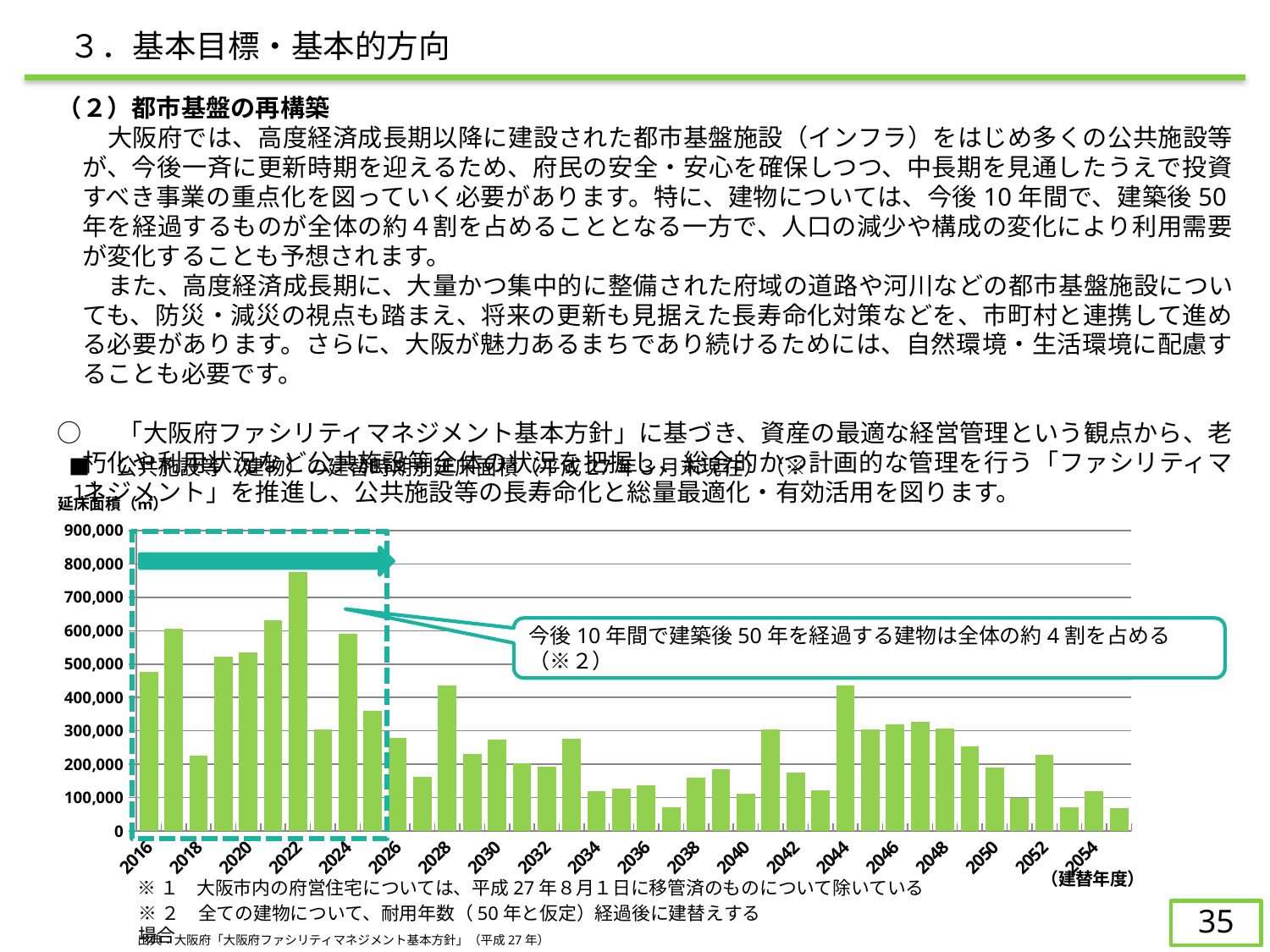
What is the label shown at the end of the horizontal axis of the chart? （建替年度） What is the label of the vertical axis of the chart? 延床面積（㎡） Is the value for 2044 greater or less than 400,000? greater Is the value for 2024 greater or less than 500,000? greater Is the value for 2018 greater or less than 300,000? less Which rebuild year (建替年度) has the highest floor area (延床面積) in the chart? 2022 What kind of chart is shown on the slide? bar chart Which is larger, the value for 2016 or the value for 2018? 2016